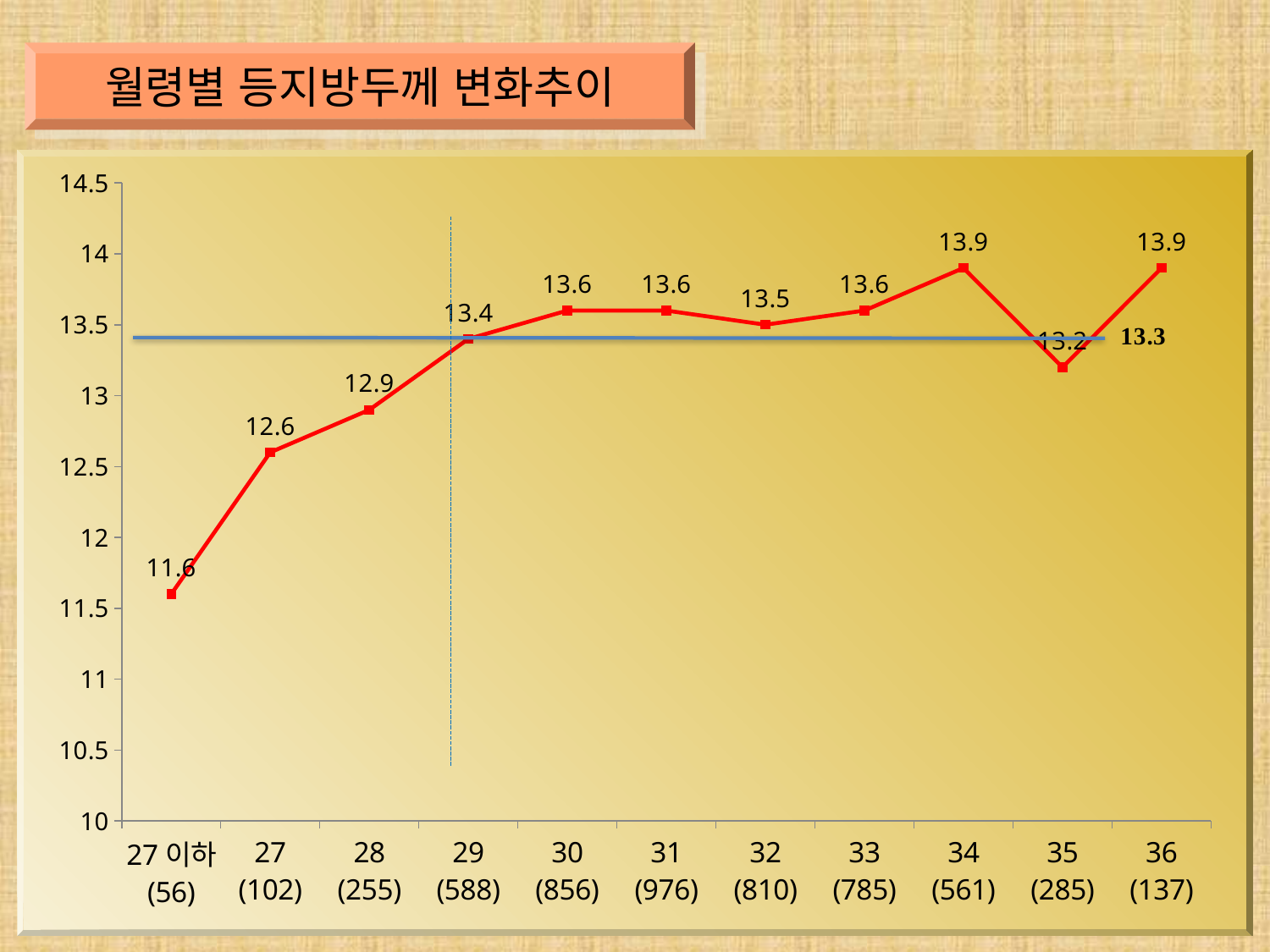
How many categories are shown on the x axis? 11 What value is labelled on the horizontal reference line? 13.3 What is the difference between the values for 27 (102) and 27 이하 (56)? 1.0 What is the difference between the values for 34 (561) and 35 (285)? 0.7 What kind of chart is shown on the slide? Line chart Which category has the lowest value? 27 이하 (56) Which is larger, the value for 28 (255) or the value for 33 (785)? 33 (785) What is the value for 35 (285)? 13.2 What is the value for 29 (588)? 13.4 What is the value for 32 (810)? 13.5 What is the value for 27 이하 (56)? 11.6 What is the highest value plotted on the line? 13.9